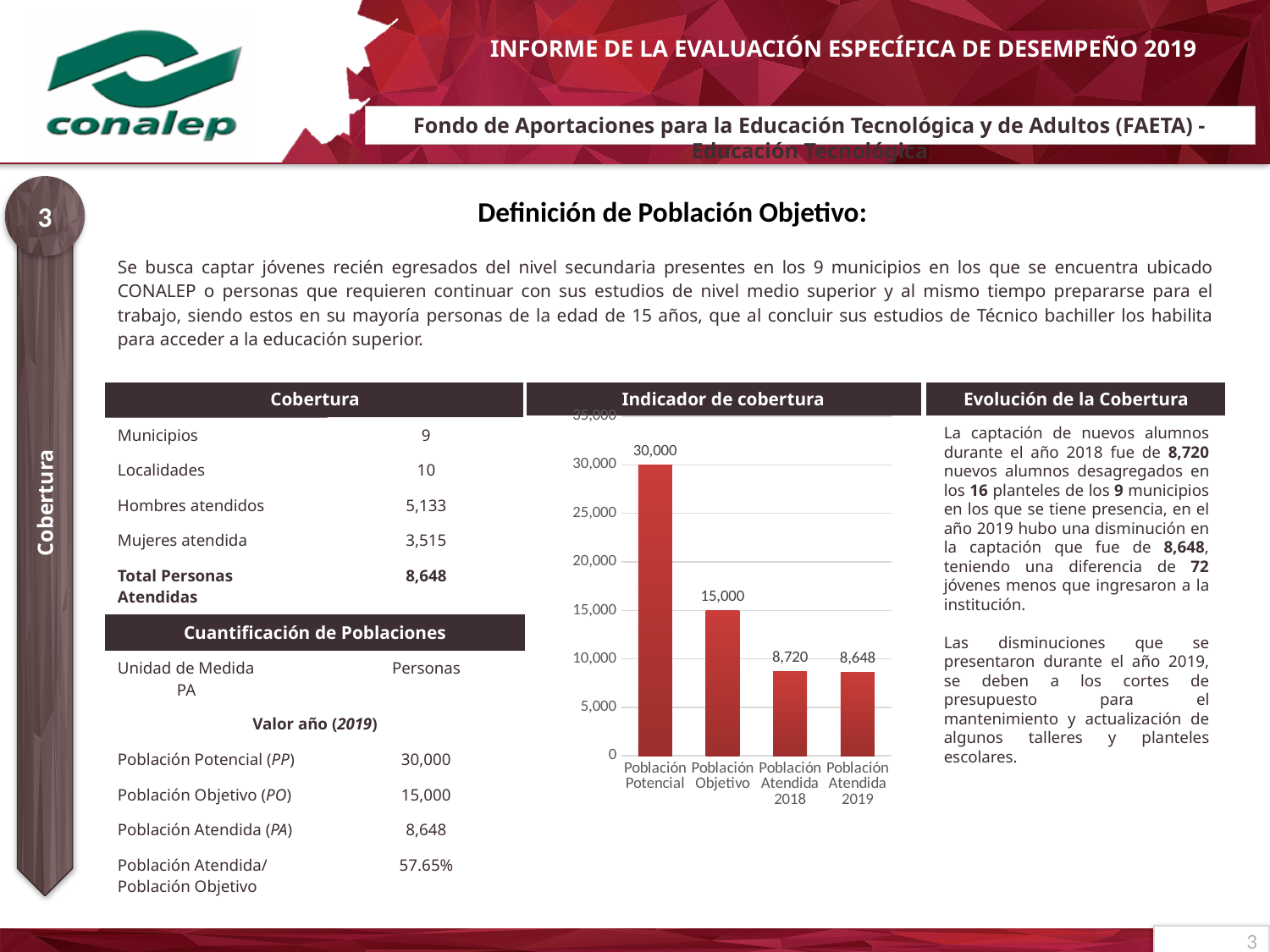
Which category has the lowest value in the Indicador de cobertura chart? Población Atendida 2019 What type of chart is the Indicador de cobertura chart? Bar chart What is the difference between Población Atendida 2018 and Población Atendida 2019 in the Indicador de cobertura chart? 72 What is the value for Población Atendida 2018 in the Indicador de cobertura chart? 8,720 Which category has the highest value in the Indicador de cobertura chart? Población Potencial In the Indicador de cobertura chart, which is larger: Población Objetivo or Población Atendida 2018? Población Objetivo What is the value for Población Objetivo in the Indicador de cobertura chart? 15,000 What is the value for Población Potencial in the Indicador de cobertura chart? 30,000 What is the value for Población Atendida 2019 in the Indicador de cobertura chart? 8,648 What is the difference between Población Potencial and Población Objetivo in the Indicador de cobertura chart? 15,000 How many categories are shown in the Indicador de cobertura chart? 4 Do the values in the Indicador de cobertura chart rise or fall from left to right? Fall